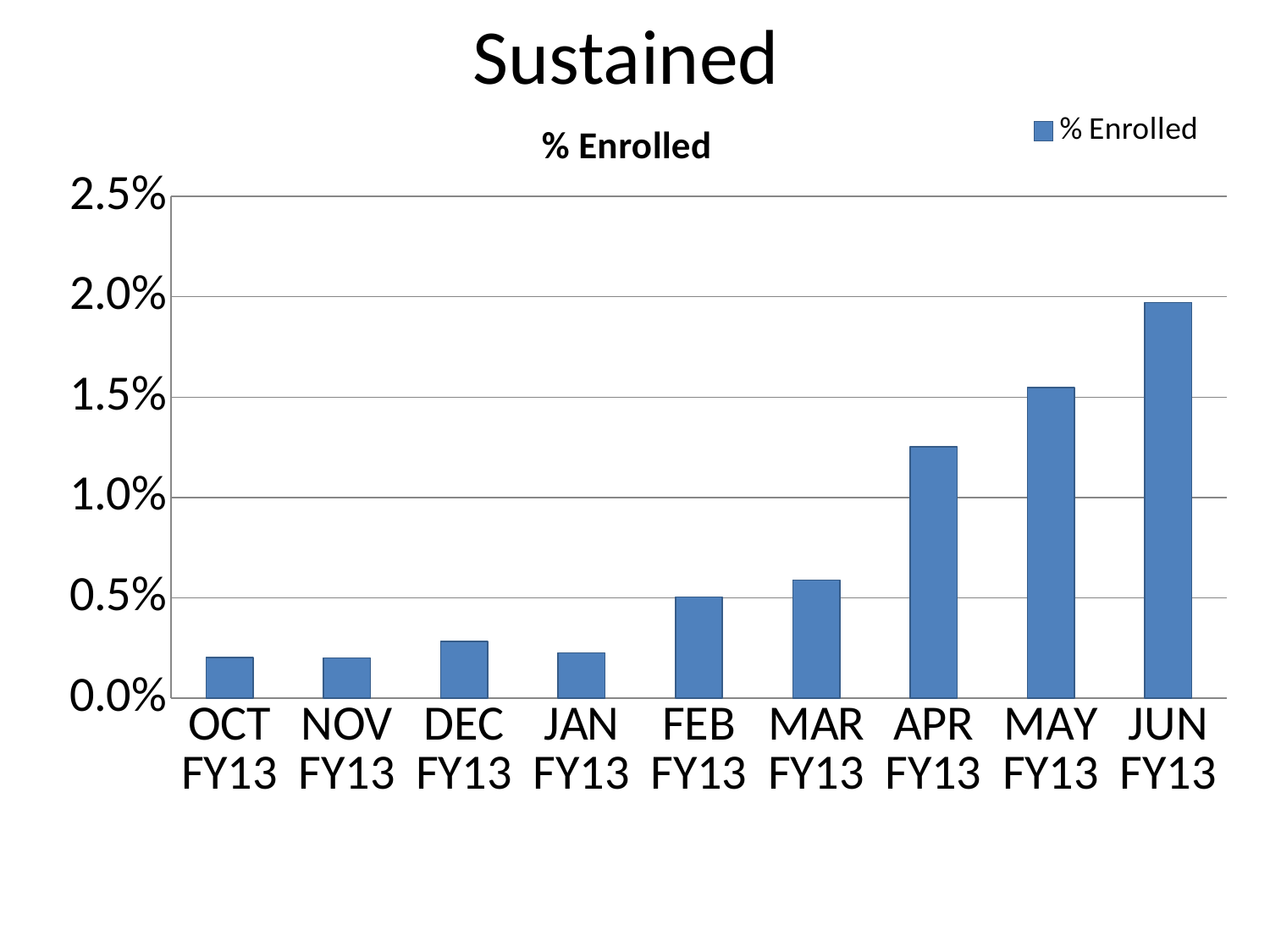
How many months are plotted on the x axis? 9 Is the value for DEC FY13 greater or less than 0.5%? less Is the value for JUN FY13 greater or less than 1.5%? greater What type of chart is shown on the slide? bar chart Is the value for MAY FY13 greater or less than 2.0%? less Do the % Enrolled values generally rise or fall from OCT FY13 to JUN FY13? rise Which is larger, the value for APR FY13 or MAR FY13? APR FY13 What is the title of the chart? % Enrolled How many series does the legend list? 1 Which month has the highest % Enrolled? JUN FY13 Which is larger, the value for FEB FY13 or DEC FY13? FEB FY13